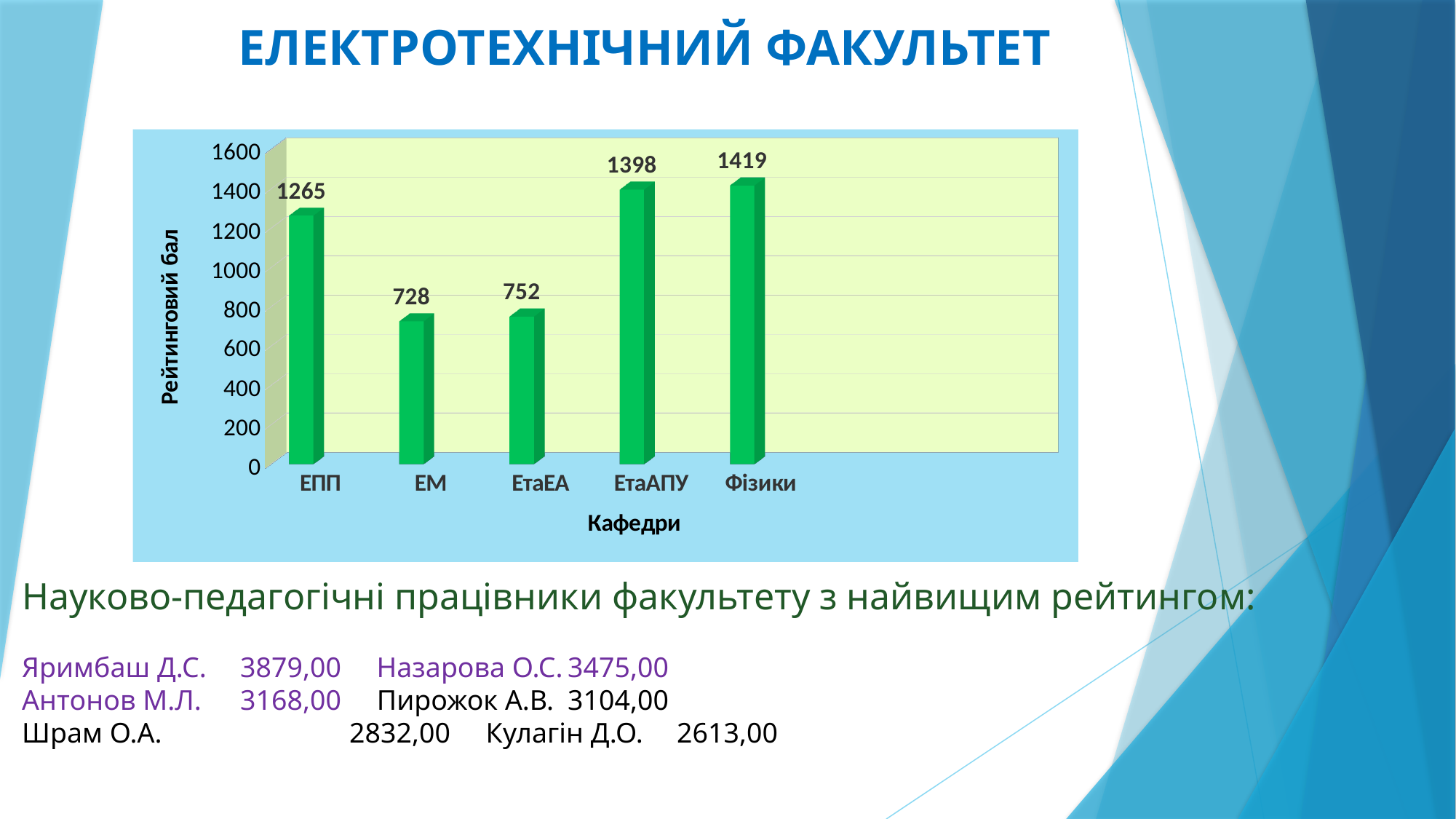
What is the rating score for ЕтаАПУ? 1398 What is the label of the vertical axis of the chart? Рейтинговий бал What is the rating score for ЕМ? 728 Which has a higher rating score, ЕПП or ЕтаЕА? ЕПП Which department has the highest rating score? Фізики Which department has the lowest rating score? ЕМ What is the difference between the rating scores of ЕтаЕА and ЕМ? 24 What is the difference between the rating scores of Фізики and ЕтаАПУ? 21 Is the value for ЕтаЕА greater or less than 1000? less How many departments are shown on the chart? 5 What kind of chart is shown on the slide? bar chart What is the rating score for ЕПП? 1265